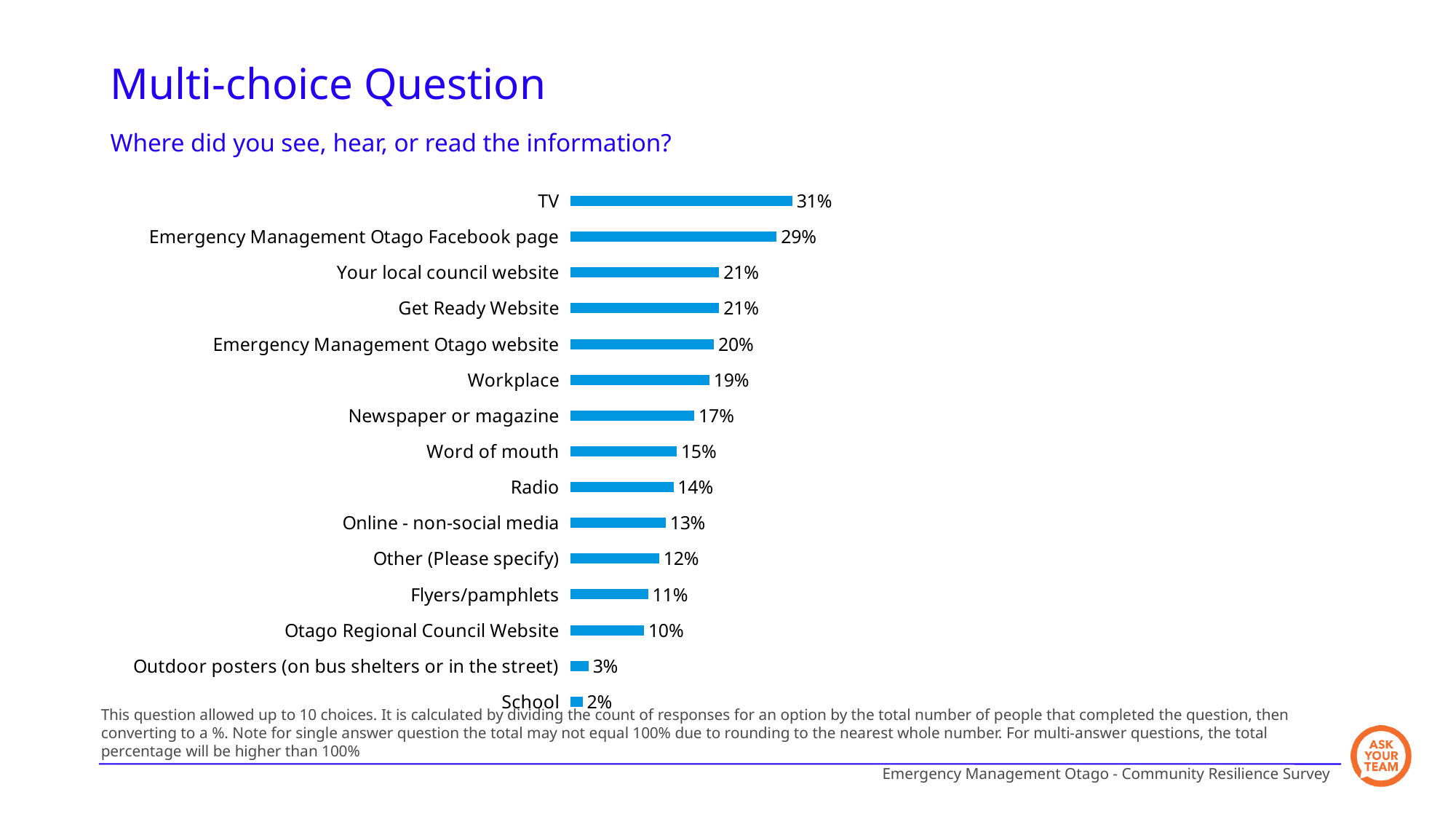
What is the value for Otago Regional Council Website? 10% Which is larger, Newspaper or magazine or Online - non-social media? Newspaper or magazine Which information source has the highest percentage? TV How many information sources are listed in the chart? 15 What percentage of respondents saw, heard, or read the information on TV? 31% What is the difference between the percentages for TV and Radio? 17% What percentage is shown for Word of mouth? 15% Which information source has the lowest percentage? School What type of chart is shown on the slide? Bar chart What is the difference between Workplace and Flyers/pamphlets? 8% What is the value for the Emergency Management Otago Facebook page? 29% What question does the chart answer, according to the subtitle? Where did you see, hear, or read the information?